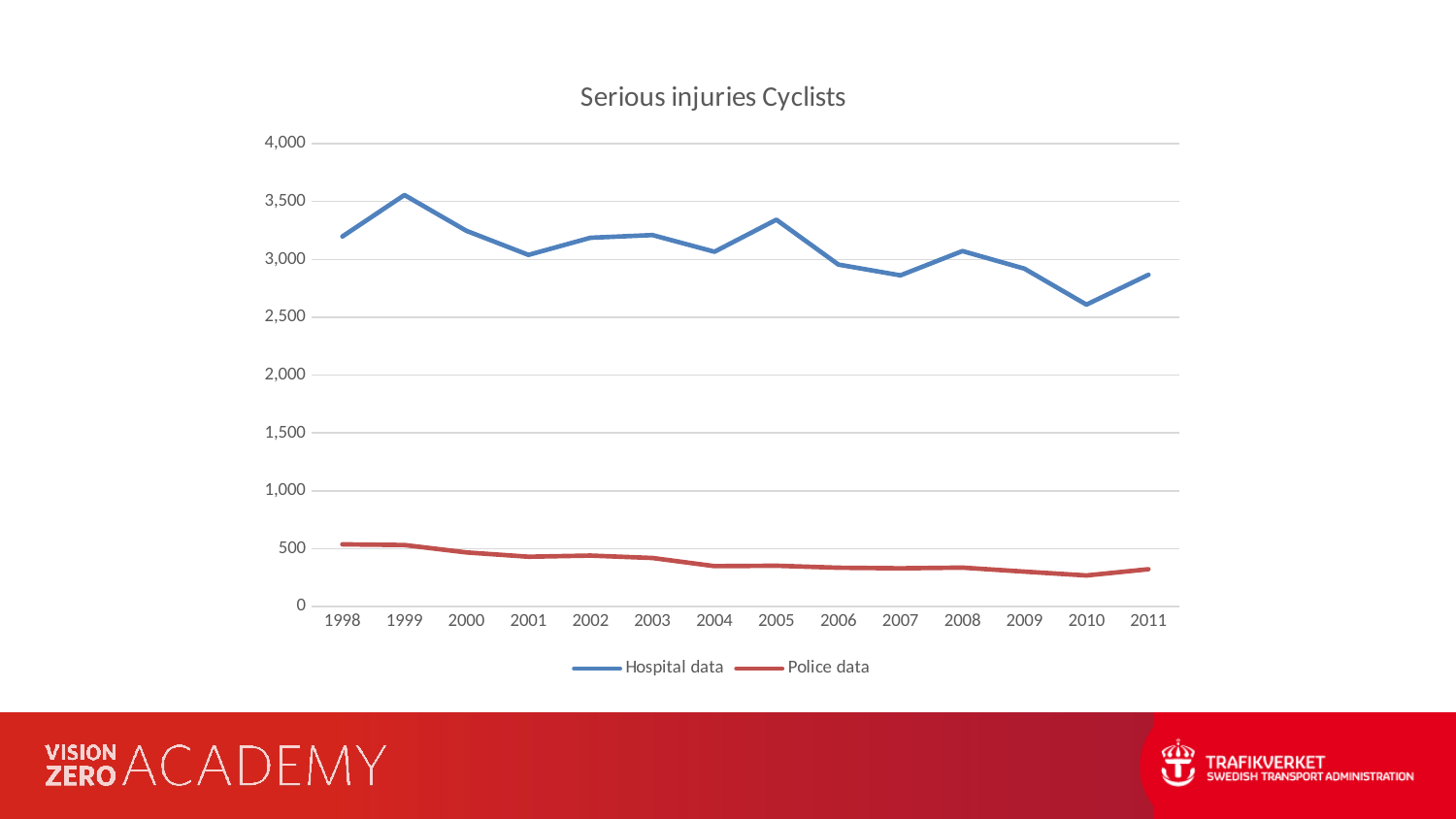
What is the title of the chart? Serious injuries Cyclists Is the Police data value for 1998 greater or less than 500? greater What kind of chart is shown on the slide? line chart In which year is the Police data series at its lowest? 2010 In which year is the Hospital data series at its highest? 1999 Is the Hospital data value for 1998 greater or less than 3,000? greater Which is larger for Hospital data: the value for 2005 or the value for 2006? 2005 How many series does the legend list? 2 How many years are plotted along the x axis? 14 In which year is the Hospital data series at its lowest? 2010 Is the Hospital data value for 2010 greater or less than 3,000? less Does the Police data series generally rise or fall from 1998 to 2011? fall